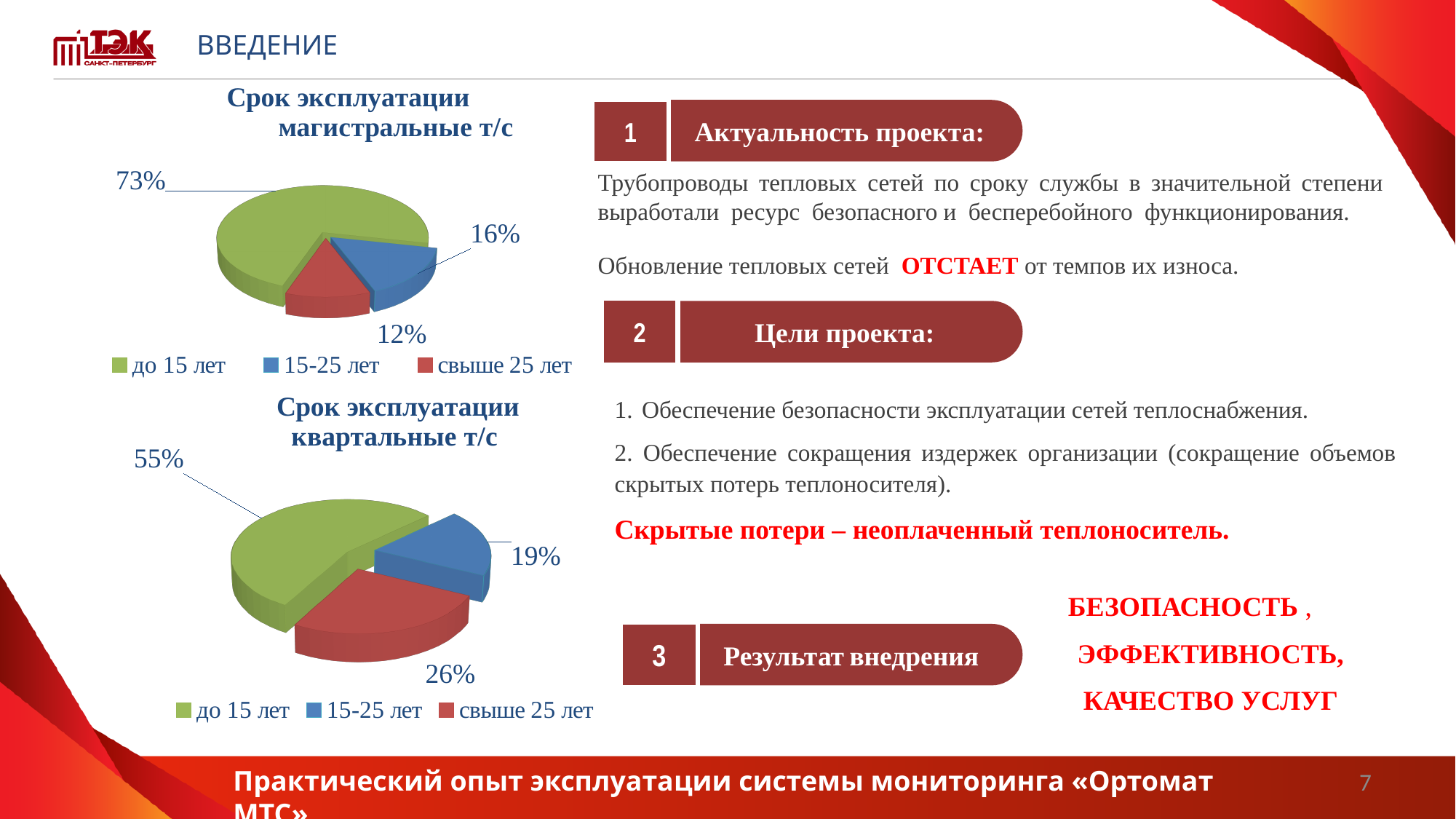
In the chart titled "Срок эксплуатации квартальные т/с", what share is shown for "свыше 25 лет"? 26% In the chart titled "Срок эксплуатации квартальные т/с", what share is shown for "до 15 лет"? 55% In the chart titled "Срок эксплуатации магистральные т/с", what share is shown for "до 15 лет"? 73% In the chart titled "Срок эксплуатации магистральные т/с", what share is shown for "свыше 25 лет"? 12% In the chart titled "Срок эксплуатации магистральные т/с", what share is shown for "15-25 лет"? 16% In the chart titled "Срок эксплуатации квартальные т/с", what share is shown for "15-25 лет"? 19% In the chart titled "Срок эксплуатации квартальные т/с", which category has the largest share? до 15 лет How many categories does the legend of the chart titled "Срок эксплуатации квартальные т/с" list? 3 What is the difference between the "до 15 лет" share in the top chart (магистральные т/с) and the "до 15 лет" share in the bottom chart (квартальные т/с)? 18% What type of chart is used for "Срок эксплуатации магистральные т/с"? Pie chart In the chart titled "Срок эксплуатации магистральные т/с", which category has the smallest share? свыше 25 лет In the chart titled "Срок эксплуатации квартальные т/с", which is larger: "свыше 25 лет" or "15-25 лет"? свыше 25 лет